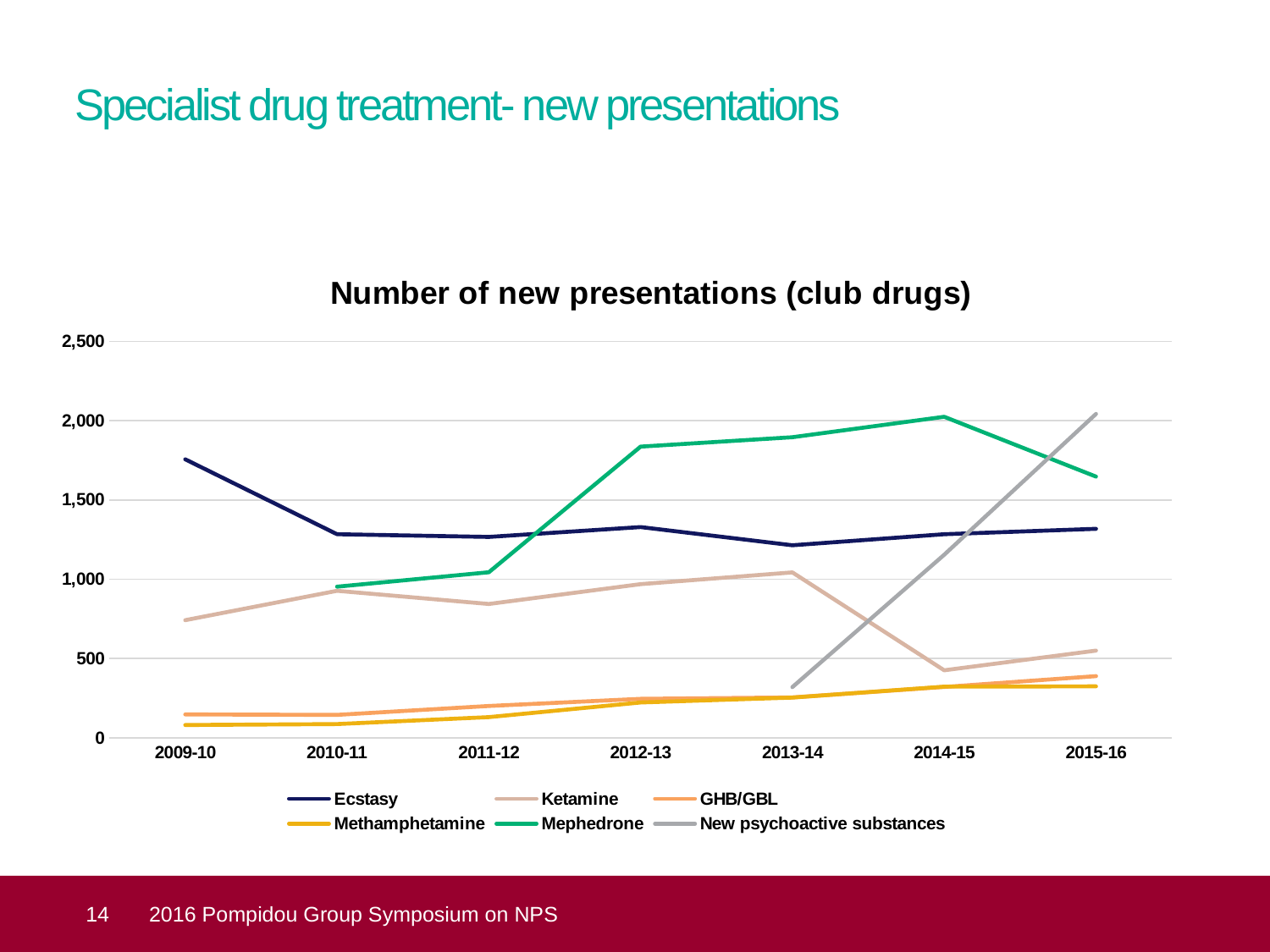
Is the value for Ecstasy in 2009-10 greater or less than 1,500? greater How many years are shown on the x axis? 7 Which series has the highest value in 2009-10? Ecstasy What is the title of the chart? Number of new presentations (club drugs) What kind of chart is shown on the slide? line chart Is the value for Ketamine in 2014-15 greater or less than 500? less How many series does the legend list? 6 Which series has the highest value in 2014-15? Mephedrone Which series has the highest value in 2015-16? New psychoactive substances Is the value for New psychoactive substances in 2013-14 greater or less than 500? less Does the New psychoactive substances line rise or fall from 2013-14 to 2015-16? rise In 2015-16, which is larger: Ecstasy or Mephedrone? Mephedrone